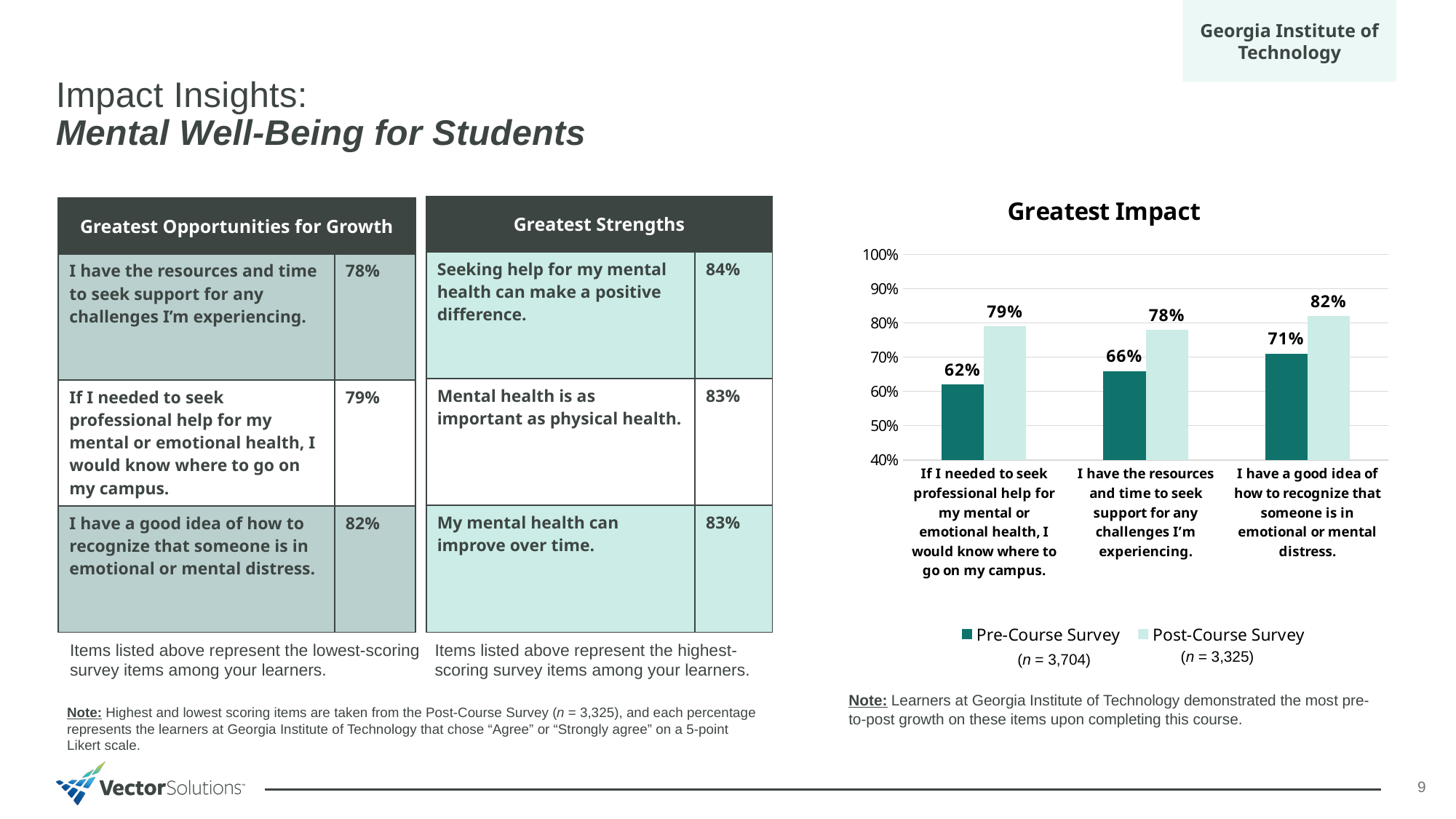
What type of chart is the "Greatest Impact" chart? Bar chart In the "Greatest Impact" chart, what is the difference between the Post-Course and Pre-Course Survey values for "If I needed to seek professional help for my mental or emotional health, I would know where to go on my campus."? 17% In the "Greatest Impact" chart, what is the Post-Course Survey value for "I have the resources and time to seek support for any challenges I'm experiencing."? 78% How many series does the legend of the "Greatest Impact" chart list? 2 What are the two series names listed in the legend of the "Greatest Impact" chart? Pre-Course Survey and Post-Course Survey In the "Greatest Impact" chart, which category has the highest Pre-Course Survey value? I have a good idea of how to recognize that someone is in emotional or mental distress. How many categories are shown on the x axis of the "Greatest Impact" chart? 3 In the "Greatest Impact" chart, which is larger: the Pre-Course Survey value for "I have the resources and time to seek support for any challenges I'm experiencing." or the Pre-Course Survey value for "I have a good idea of how to recognize that someone is in emotional or mental distress."? I have a good idea of how to recognize that someone is in emotional or mental distress. In the "Greatest Impact" chart, which category has the lowest Post-Course Survey value? I have the resources and time to seek support for any challenges I'm experiencing. In the "Greatest Impact" chart, what is the Post-Course Survey value for "I have a good idea of how to recognize that someone is in emotional or mental distress."? 82% In the "Greatest Impact" chart, is the Pre-Course Survey value for "I have the resources and time to seek support for any challenges I'm experiencing." greater or less than 70%? less In the "Greatest Impact" chart, what is the Pre-Course Survey value for "If I needed to seek professional help for my mental or emotional health, I would know where to go on my campus."? 62%